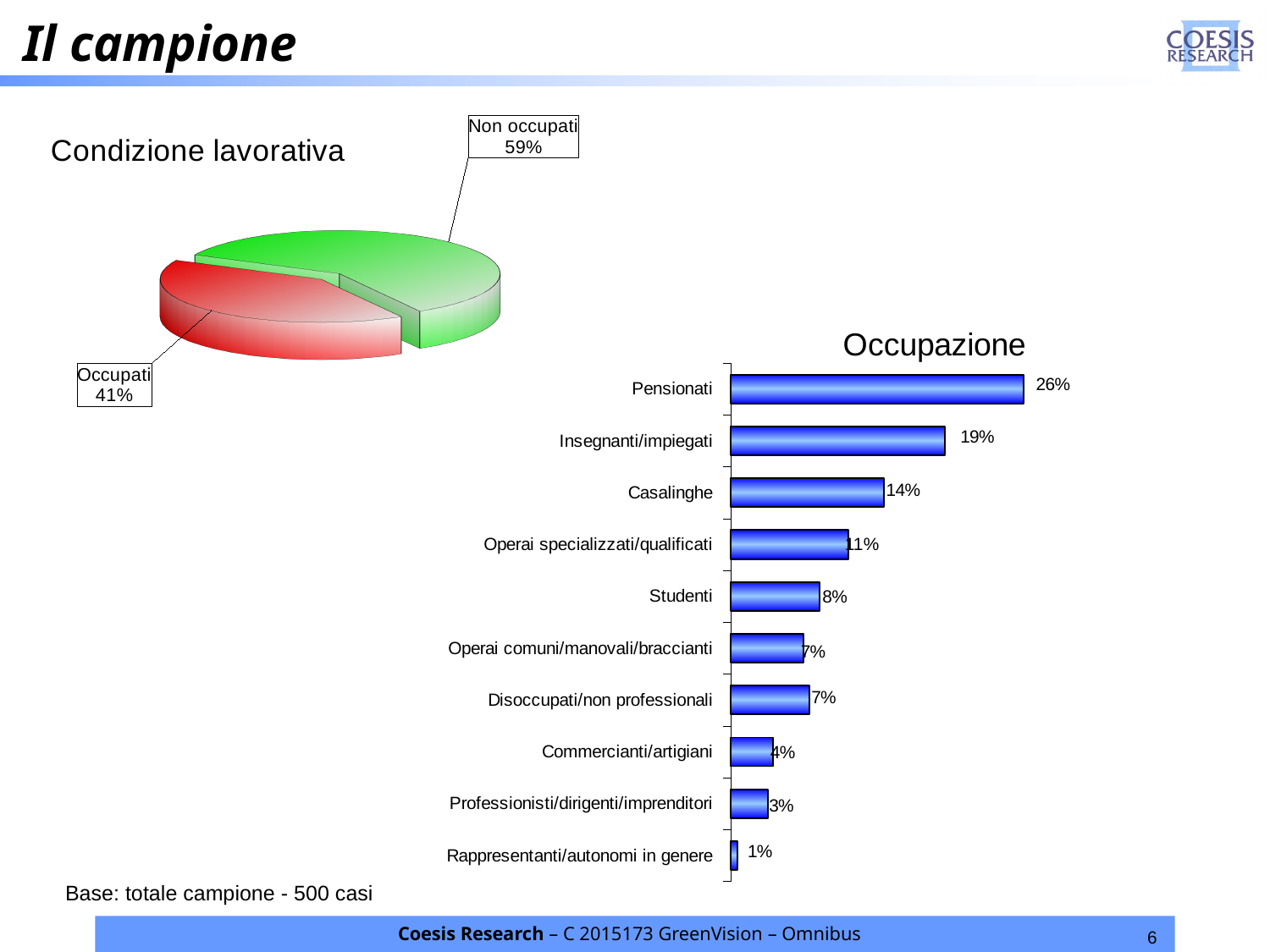
In the 'Occupazione' chart, which category has the highest value? Pensionati In the 'Condizione lavorativa' pie chart, how many slices are there? 2 In the 'Occupazione' chart, how many categories are shown? 10 In the 'Condizione lavorativa' pie chart, what is the share for Occupati? 41% In the 'Condizione lavorativa' pie chart, what is the share for Non occupati? 59% In the 'Condizione lavorativa' pie chart, which slice is larger, Occupati or Non occupati? Non occupati In the 'Occupazione' chart, what is the difference between Pensionati and Insegnanti/impiegati? 7% What kind of chart is the 'Condizione lavorativa' chart? Pie chart In the 'Occupazione' chart, which category has the lowest value? Rappresentanti/autonomi in genere In the 'Occupazione' chart, what is the value for Casalinghe? 14% What kind of chart is the 'Occupazione' chart? Bar chart In the 'Occupazione' chart, what is the value for Pensionati? 26%